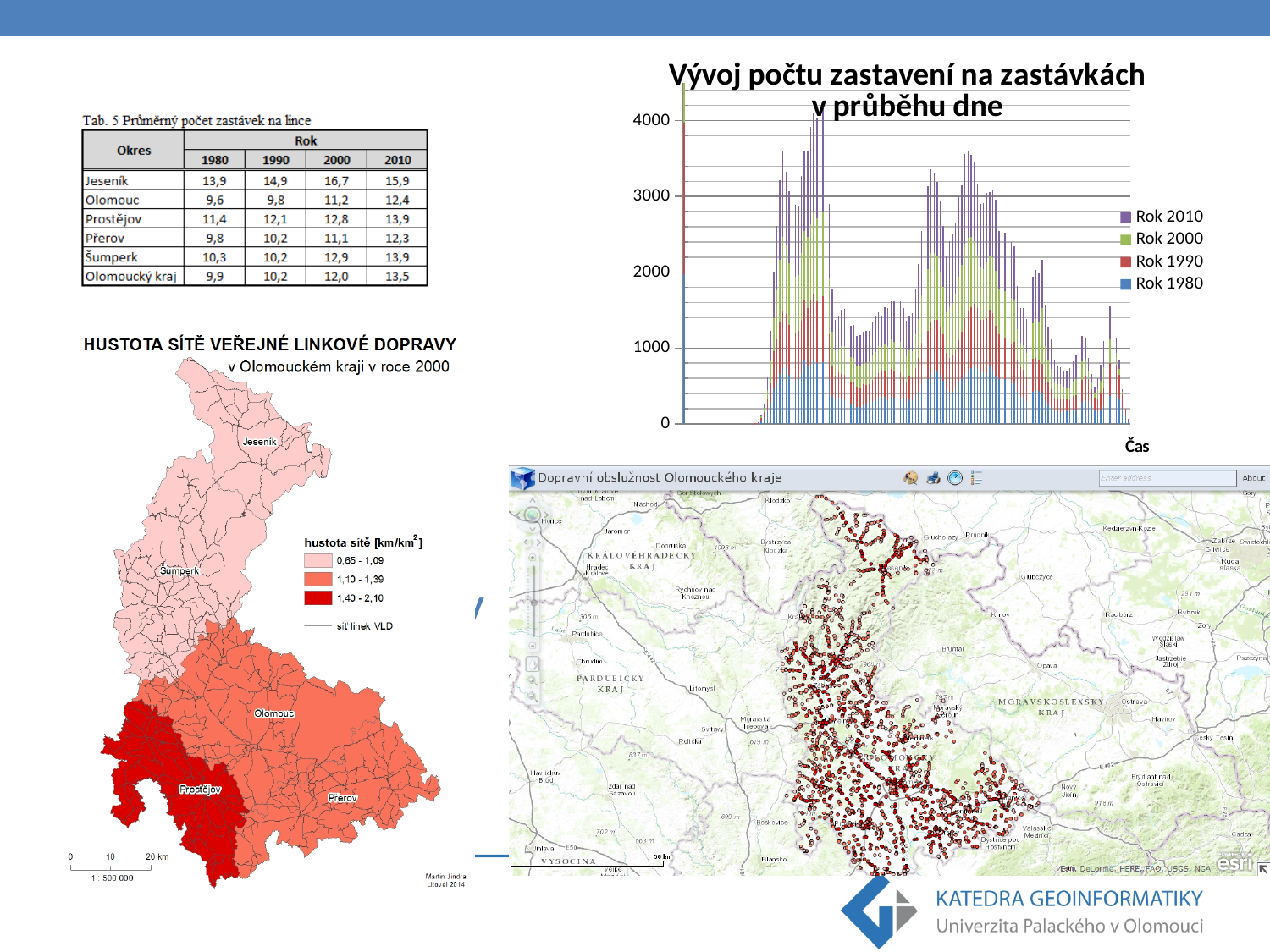
What kind of chart is shown under the title 'Vývoj počtu zastavení na zastávkách v průběhu dne'? bar chart Which years are listed in the legend of the chart 'Vývoj počtu zastavení na zastávkách v průběhu dne'? Rok 2010, Rok 2000, Rok 1990, Rok 1980 In the chart 'Vývoj počtu zastavení na zastávkách v průběhu dne', are the bars at the far right end of the x axis greater or less than 2000? less What is the label of the horizontal axis of the chart 'Vývoj počtu zastavení na zastávkách v průběhu dne'? Čas How many series does the legend of the chart 'Vývoj počtu zastavení na zastávkách v průběhu dne' list? 4 What is the highest tick value shown on the vertical axis of the chart 'Vývoj počtu zastavení na zastávkách v průběhu dne'? 4000 In the chart 'Vývoj počtu zastavení na zastávkách v průběhu dne', is the tallest stacked bar greater or less than 3000? greater